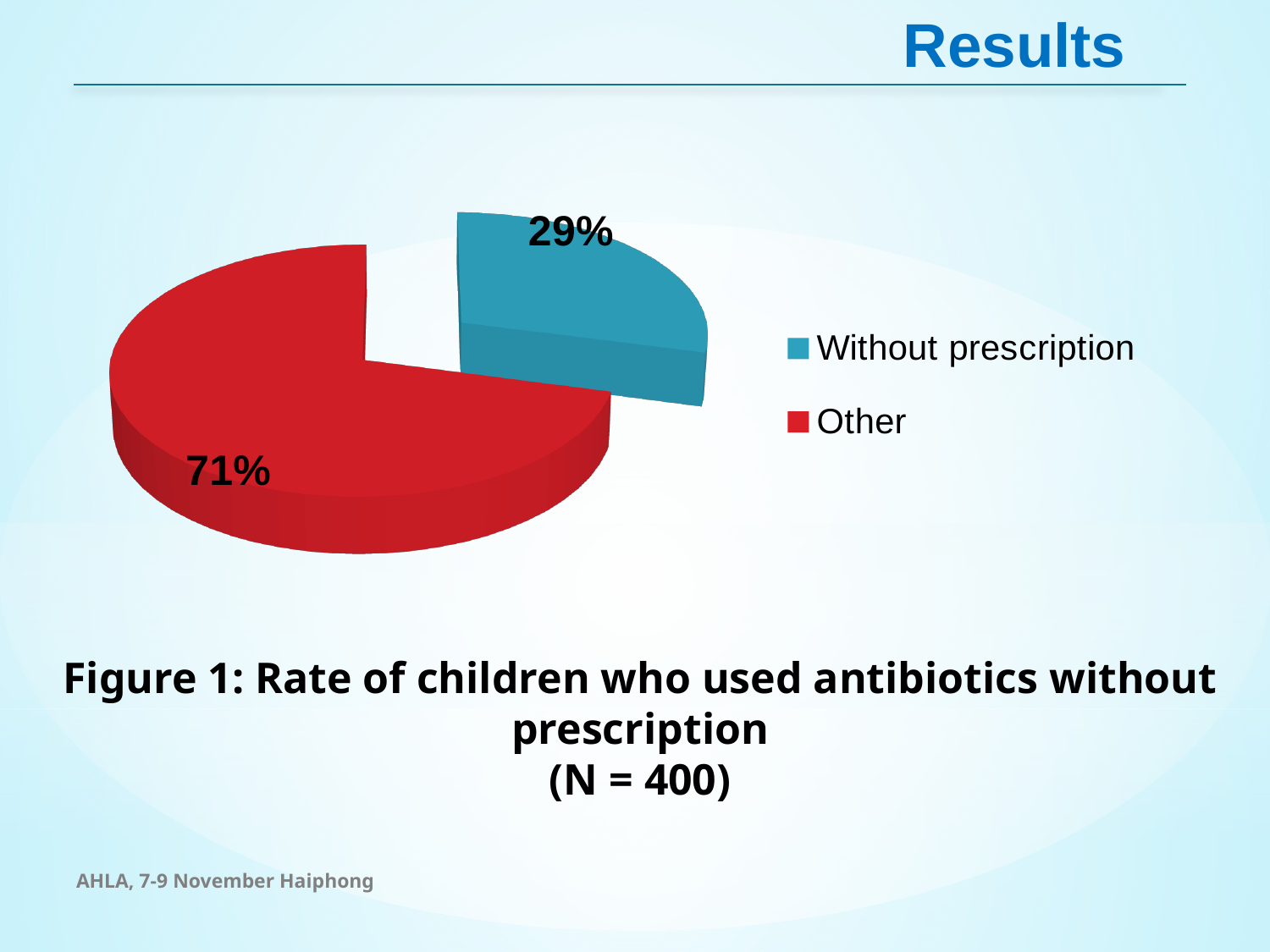
What colour is the "Other" slice in the pie chart? Red What is the sample size (N) stated in the figure caption? 400 Which slice of the pie is the largest? Other Which is larger, the "Without prescription" slice or the "Other" slice? Other How many entries does the legend list? 2 How many slices does the pie chart have? 2 What kind of chart is shown on the slide? Pie chart What share of the pie does the "Without prescription" slice represent? 29% Which slice of the pie is the smallest? Without prescription What percentage of the pie is labelled "Without prescription"? 29% What percentage of the pie is labelled "Other"? 71% What is the difference in percentage points between the "Other" slice and the "Without prescription" slice? 42